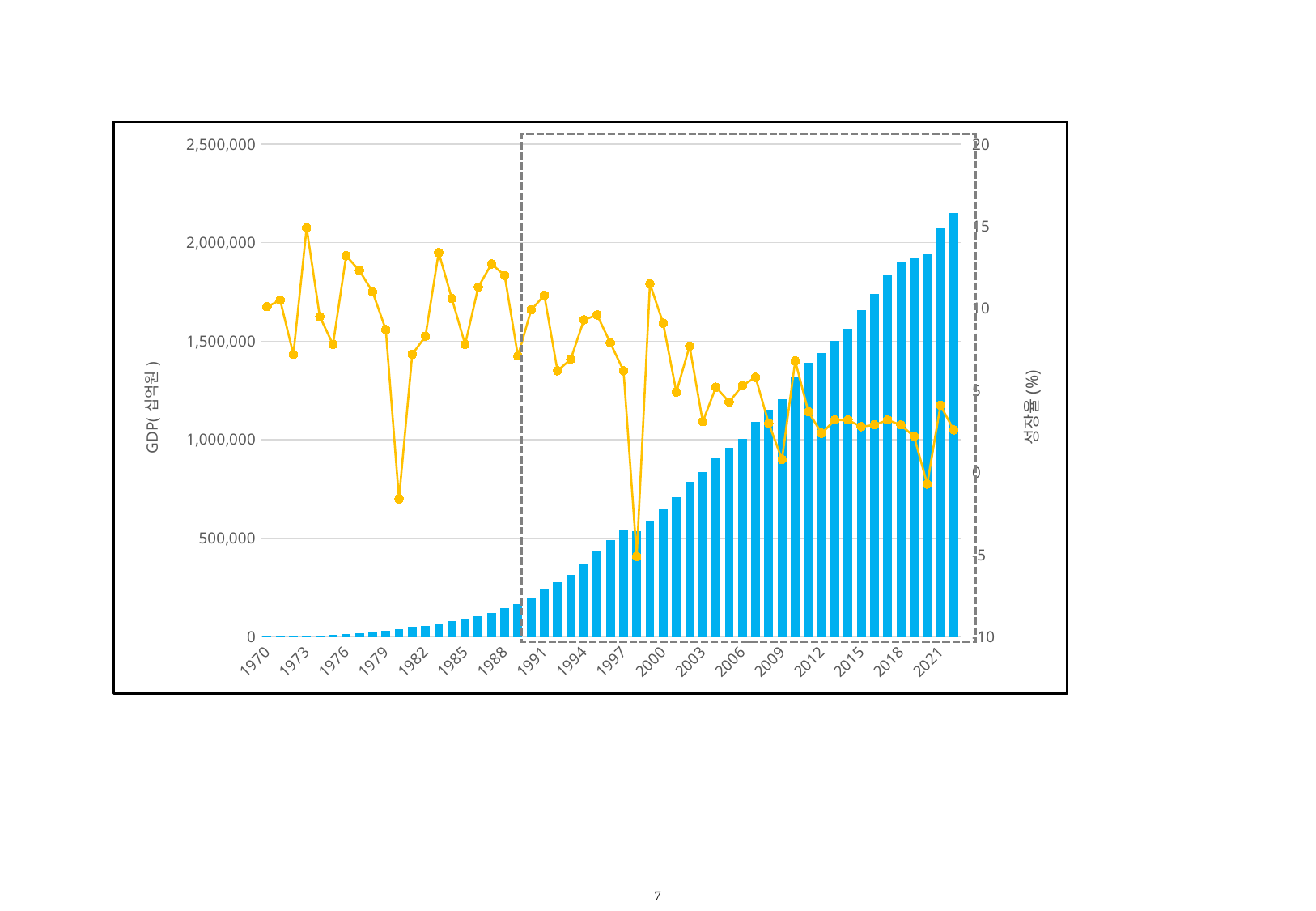
Do the GDP bars generally rise or fall from 1970 to 2021? Rise Is the GDP bar for 2021 greater or less than 2,000,000? greater Which year has the larger GDP bar, 2000 or 2015? 2015 Is the growth rate for 2020 greater or less than 0? less In which year is the growth rate (성장률) line at its highest point? 1973 In which year is the growth rate (성장률) line at its lowest point? 1998 Is the GDP bar for 2009 greater or less than 1,000,000? greater What is the title of the right vertical axis? 성장률 (%) What kind of chart is shown on the slide? A combination bar and line chart What is the title of the left vertical axis? GDP( 십억원 )